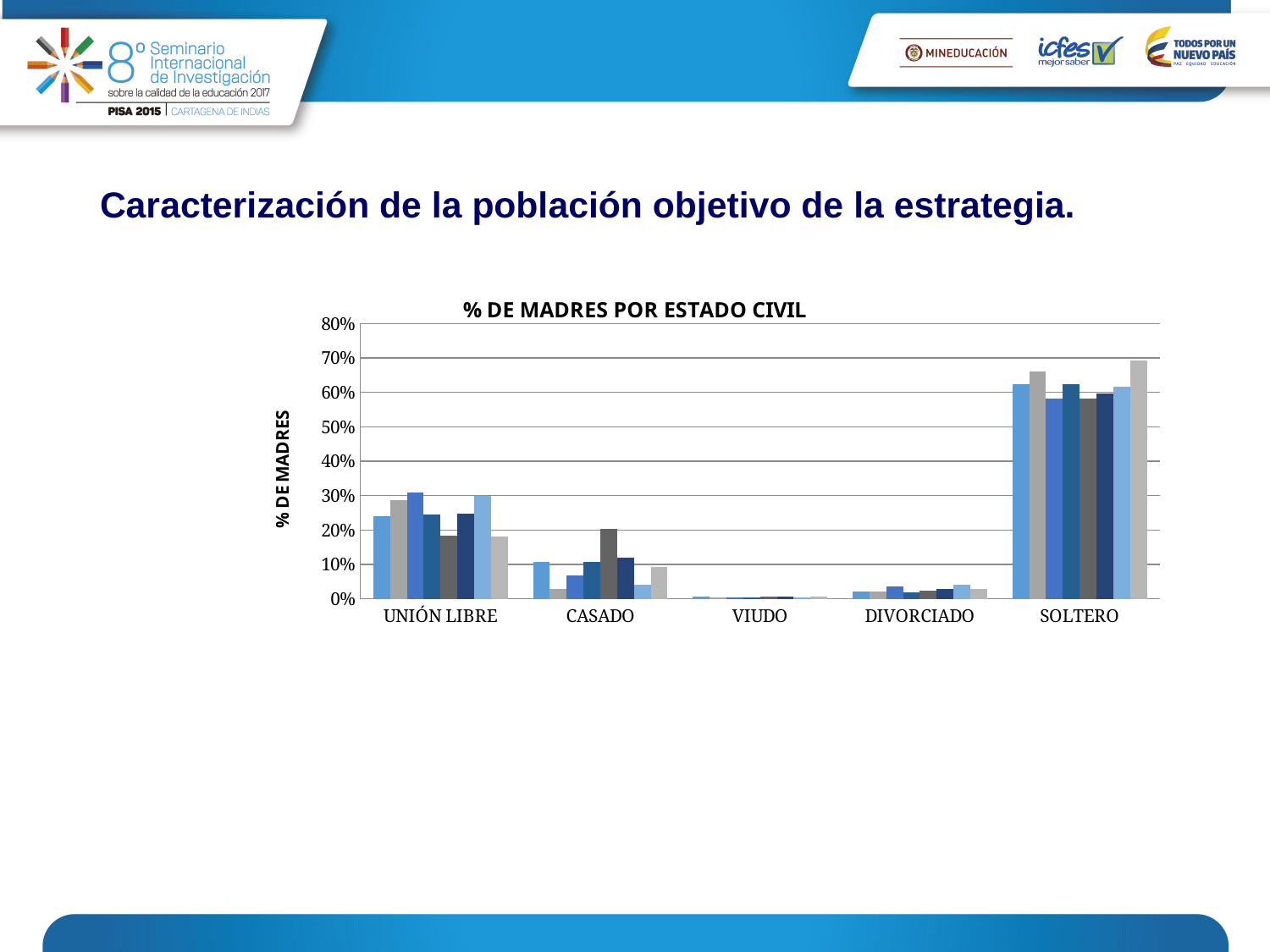
What kind of chart is shown on the slide? bar chart Which marital status category has the highest percentage of mothers? SOLTERO Are the values for DIVORCIADO greater or less than 10%? less What is the label on the vertical axis of the chart? % DE MADRES Are the values for UNIÓN LIBRE greater or less than 40%? less How many marital status categories are shown on the x axis? 5 Are the values for SOLTERO greater or less than 50%? greater What is the title of the chart? % DE MADRES POR ESTADO CIVIL Which category has higher values, UNIÓN LIBRE or CASADO? UNIÓN LIBRE What is the highest value shown on the vertical axis? 80% Which marital status category has the lowest percentage of mothers? VIUDO